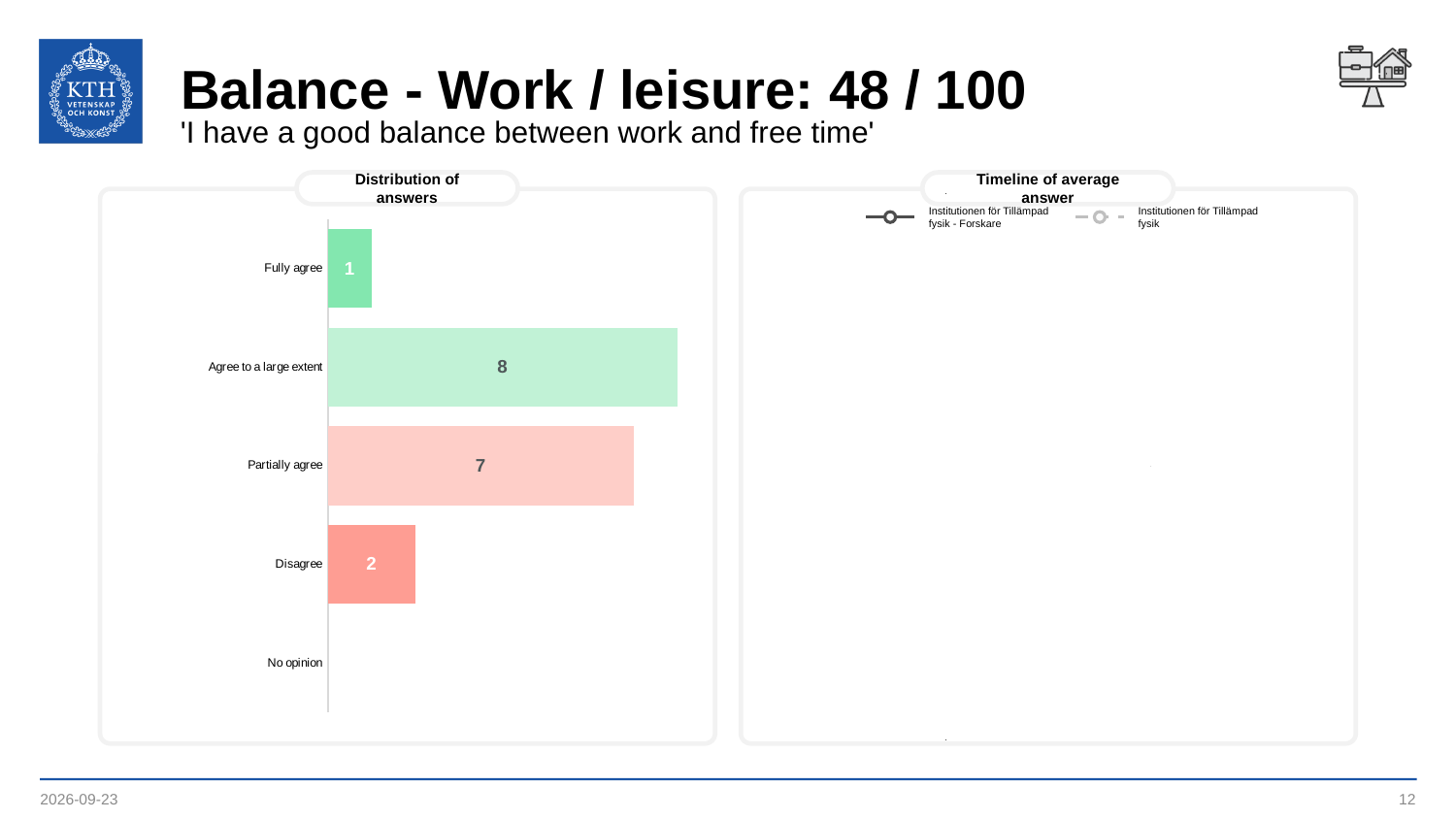
In the 'Distribution of answers' chart, what is the value for 'Disagree'? 2 In the 'Distribution of answers' chart, which category has the highest value? Agree to a large extent How many series does the legend of the 'Timeline of average answer' chart list? 2 In the 'Distribution of answers' chart, what is the value for 'Fully agree'? 1 In the 'Distribution of answers' chart, which of the labelled bars has the lowest value? Fully agree In the 'Distribution of answers' chart, what is the difference between 'Agree to a large extent' and 'Partially agree'? 1 How many categories are listed on the axis of the 'Distribution of answers' chart? 5 In the 'Distribution of answers' chart, what is the value for 'Agree to a large extent'? 8 What kind of chart is the 'Distribution of answers' chart? Bar chart In the 'Distribution of answers' chart, which is larger: 'Disagree' or 'Fully agree'? Disagree In the 'Distribution of answers' chart, what is the value for 'Partially agree'? 7 In the 'Distribution of answers' chart, what is the difference between 'Partially agree' and 'Disagree'? 5